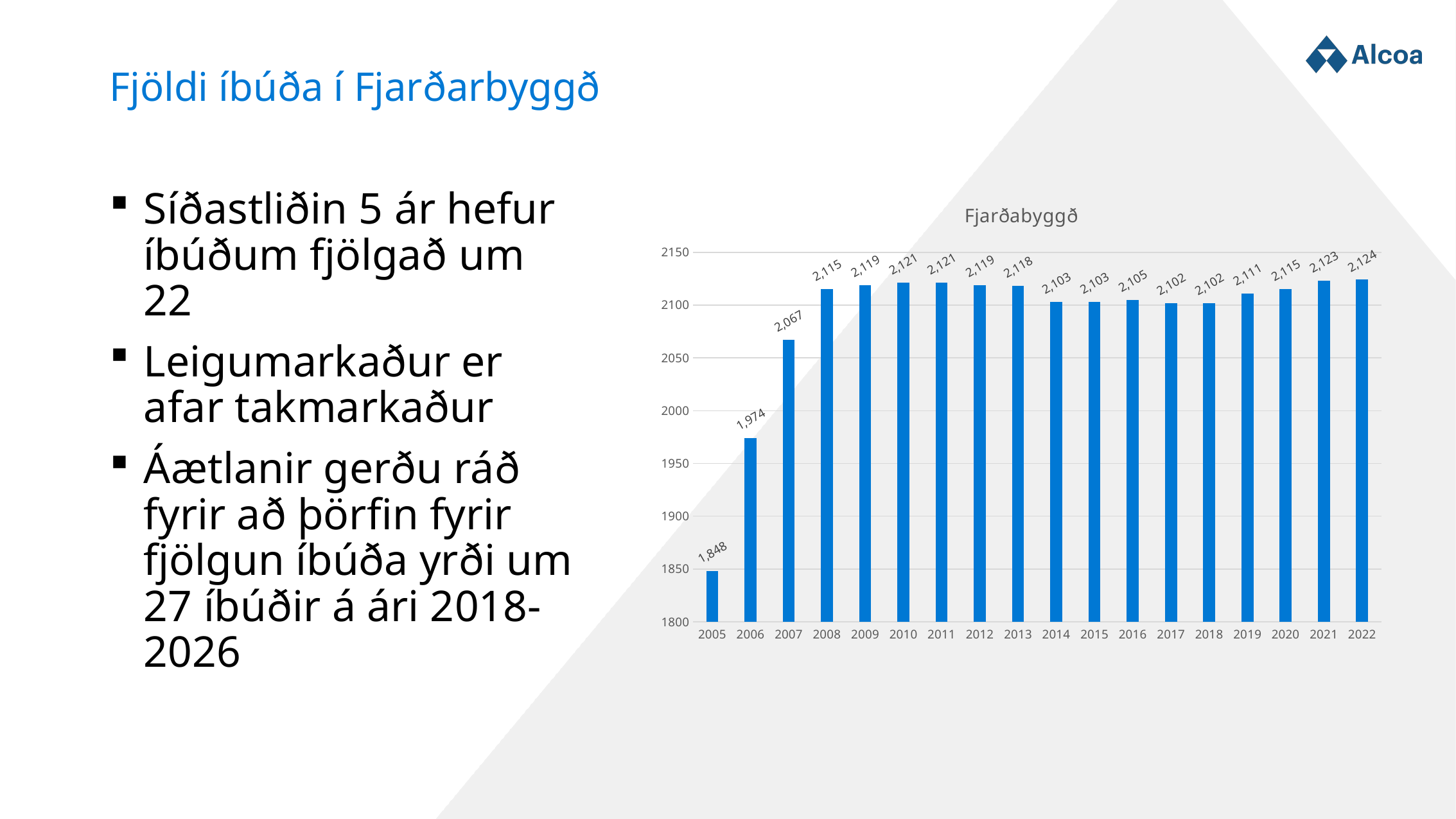
Which year has the lowest value? 2005 How many years are shown on the x axis? 18 Which is larger, the value for 2008 or the value for 2018? 2008 What is the title of the chart? Fjarðabyggð What is the value for 2022? 2,124 What kind of chart is shown? bar chart What is the value for 2005? 1,848 What is the difference between the values for 2007 and 2006? 93 What is the value for 2014? 2,103 What is the difference between the values for 2022 and 2017? 22 Is the value for 2006 greater or less than 2000? less Which year has the highest value? 2022